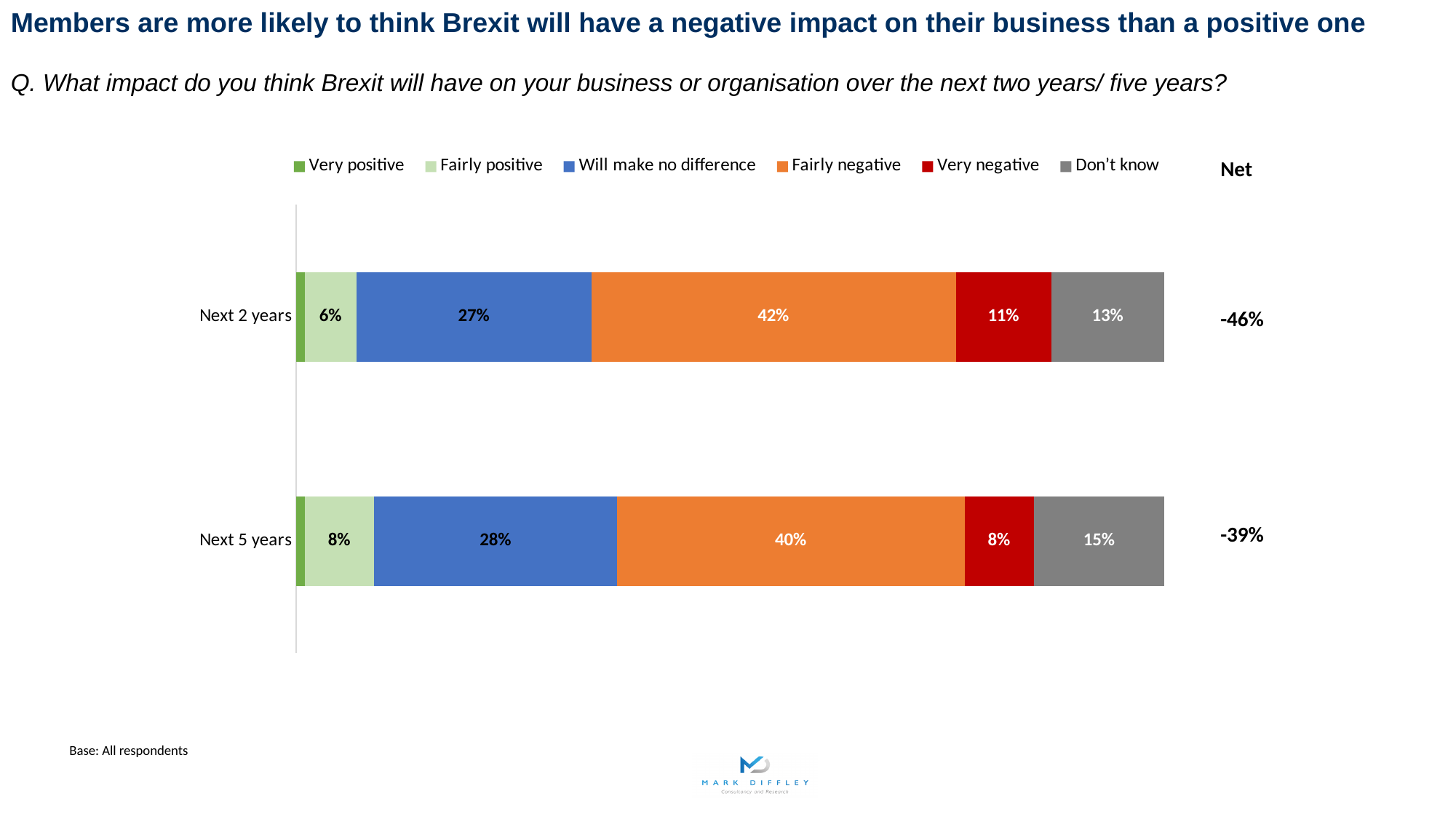
What kind of chart is shown on the slide? Stacked bar chart How many time periods (categories) are shown in the chart? 2 How many response options does the legend list? 6 Is the 'Very negative' share larger for the Next 2 years or the Next 5 years? Next 2 years What is the Net score shown for the Next 5 years? -39% What is the 'Fairly positive' value for the Next 2 years? 6% By how many percentage points does the 'Fairly negative' share for the Next 2 years exceed that for the Next 5 years? 2 percentage points What is the value for 'Will make no difference' in the Next 5 years bar? 28% What is the 'Very negative' value for the Next 5 years? 8% What percentage of members think Brexit will have a fairly negative impact on their business over the next 2 years? 42% What percentage answered 'Don't know' for the Next 2 years? 13% Which response has the largest segment in the Next 2 years bar? Fairly negative